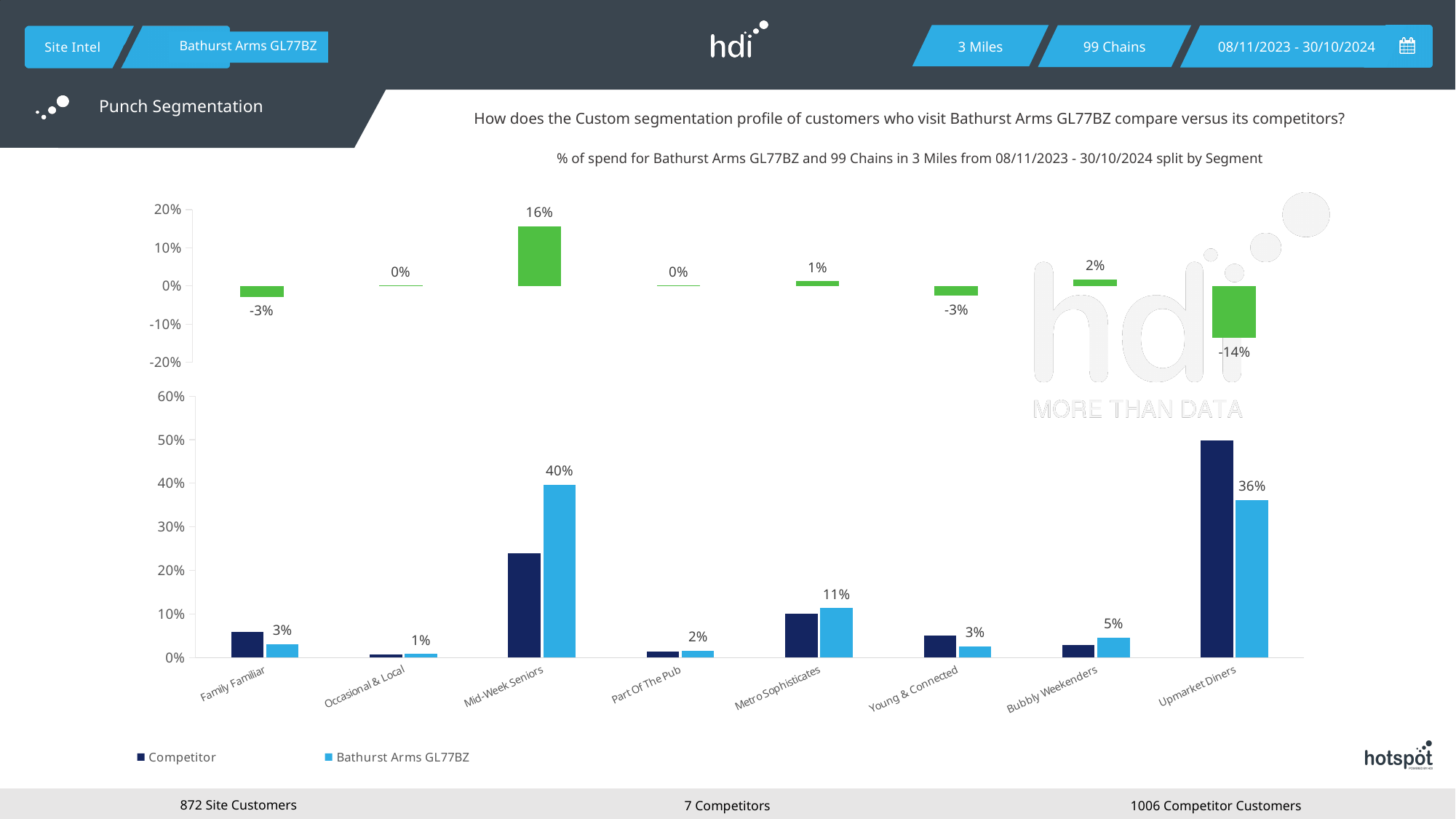
In the bottom chart, which segment has the highest value for Bathurst Arms GL77BZ? Mid-Week Seniors In the top chart, which segment has the highest value? Mid-Week Seniors What kind of chart is the bottom chart? Bar chart In the bottom chart, for Upmarket Diners, which series has the larger value: Competitor or Bathurst Arms GL77BZ? Competitor In the top chart, what is the value shown for Bubbly Weekenders? 2% How many series does the legend of the bottom chart list? 2 In the bottom chart, what is the difference between the Bathurst Arms GL77BZ values for Mid-Week Seniors and Upmarket Diners? 4 percentage points How many segments are shown on the x axis of the bottom chart? 8 In the bottom chart, is the Competitor value for Upmarket Diners greater or less than 40%? greater In the top chart, which segment has the lowest value? Upmarket Diners In the bottom chart, what is the value for Bathurst Arms GL77BZ in the Mid-Week Seniors segment? 40% In the top chart, what is the value shown for Upmarket Diners? -14%